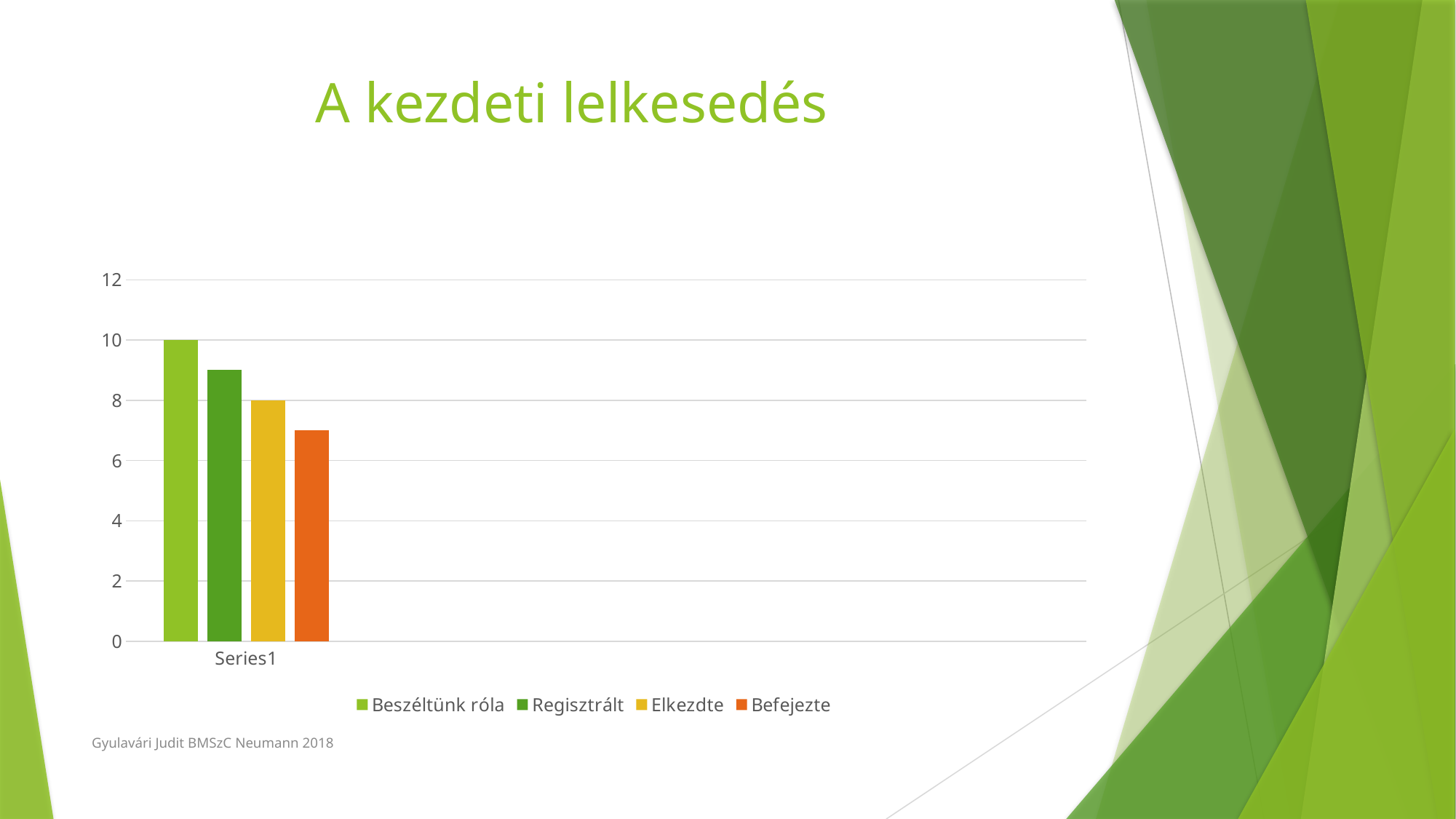
What kind of chart is shown on the slide? bar chart What is the value of the Beszéltünk róla bar? 10 What is the value of the Elkezdte bar? 8 How many categories are shown on the x axis? 1 Which series has the highest bar? Beszéltünk róla What is the title of the chart slide? A kezdeti lelkesedés Do the bars rise or fall from left to right across the series? fall Is the value for Befejezte greater or less than 8? less What is the difference between the Beszéltünk róla bar and the Elkezdte bar? 2 How many series does the legend list? 4 Is the value for Regisztrált greater or less than 8? greater Which series has the lowest bar? Befejezte